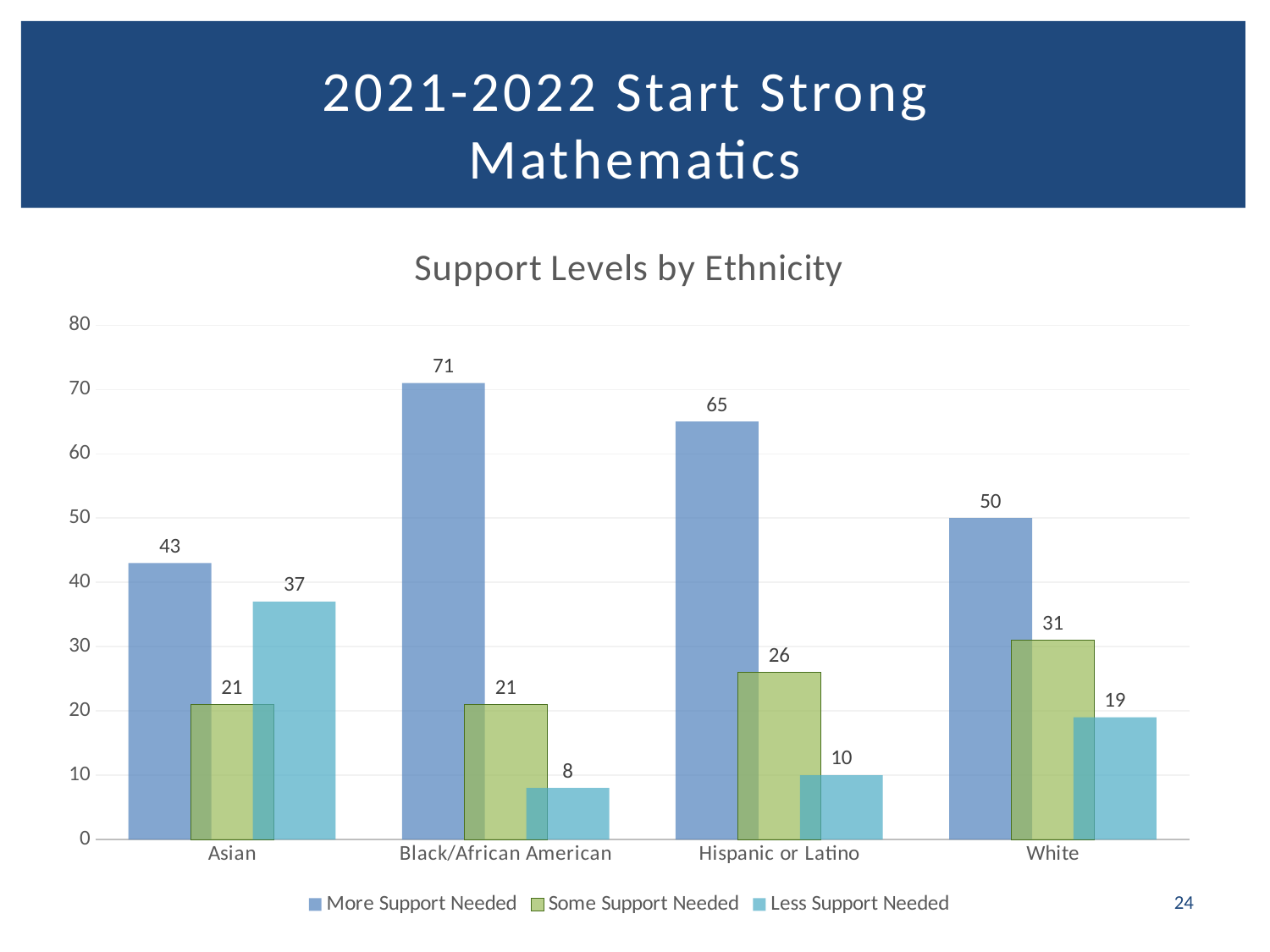
What is the value for More Support Needed for Black/African American? 71 What is the value for Less Support Needed for Asian? 37 Which is larger for Asian: Some Support Needed or Less Support Needed? Less Support Needed How many series does the legend list? 3 What is the title of the chart? Support Levels by Ethnicity Which ethnicity has the highest value for More Support Needed? Black/African American What is the value for Some Support Needed for Hispanic or Latino? 26 Is the value for More Support Needed for Hispanic or Latino greater or less than 60? greater What is the difference between More Support Needed and Less Support Needed for White? 31 How many ethnicity categories are shown on the x axis? 4 Which ethnicity has the lowest value for Less Support Needed? Black/African American What kind of chart is shown on the slide? Bar chart